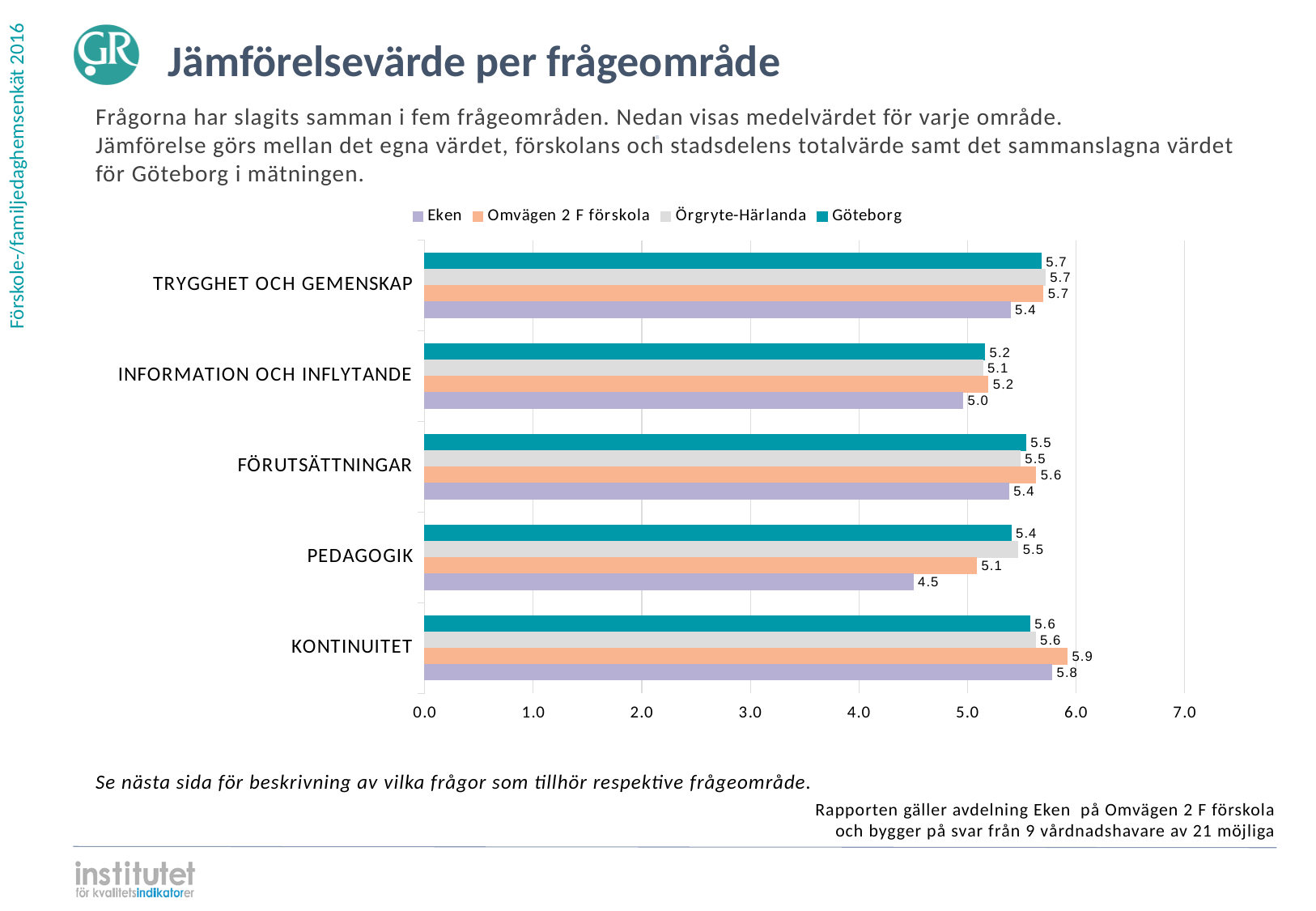
In which category does Eken have its lowest value? PEDAGOGIK What is the value for Göteborg in the INFORMATION OCH INFLYTANDE category? 5.2 How many categories are shown on the chart? 5 Which is larger in the KONTINUITET category: the value for Eken or the value for Göteborg? Eken What kind of chart is shown on the slide? Bar chart What is the value for Eken in the PEDAGOGIK category? 4.5 What is the difference between the Omvägen 2 F förskola value and the Eken value in the PEDAGOGIK category? 0.6 How many series does the legend list? 4 What is the value for Omvägen 2 F förskola in the KONTINUITET category? 5.9 Which series is shown in purple in the legend? Eken What is the value for Örgryte-Härlanda in the FÖRUTSÄTTNINGAR category? 5.5 In which category does Eken have its highest value? KONTINUITET